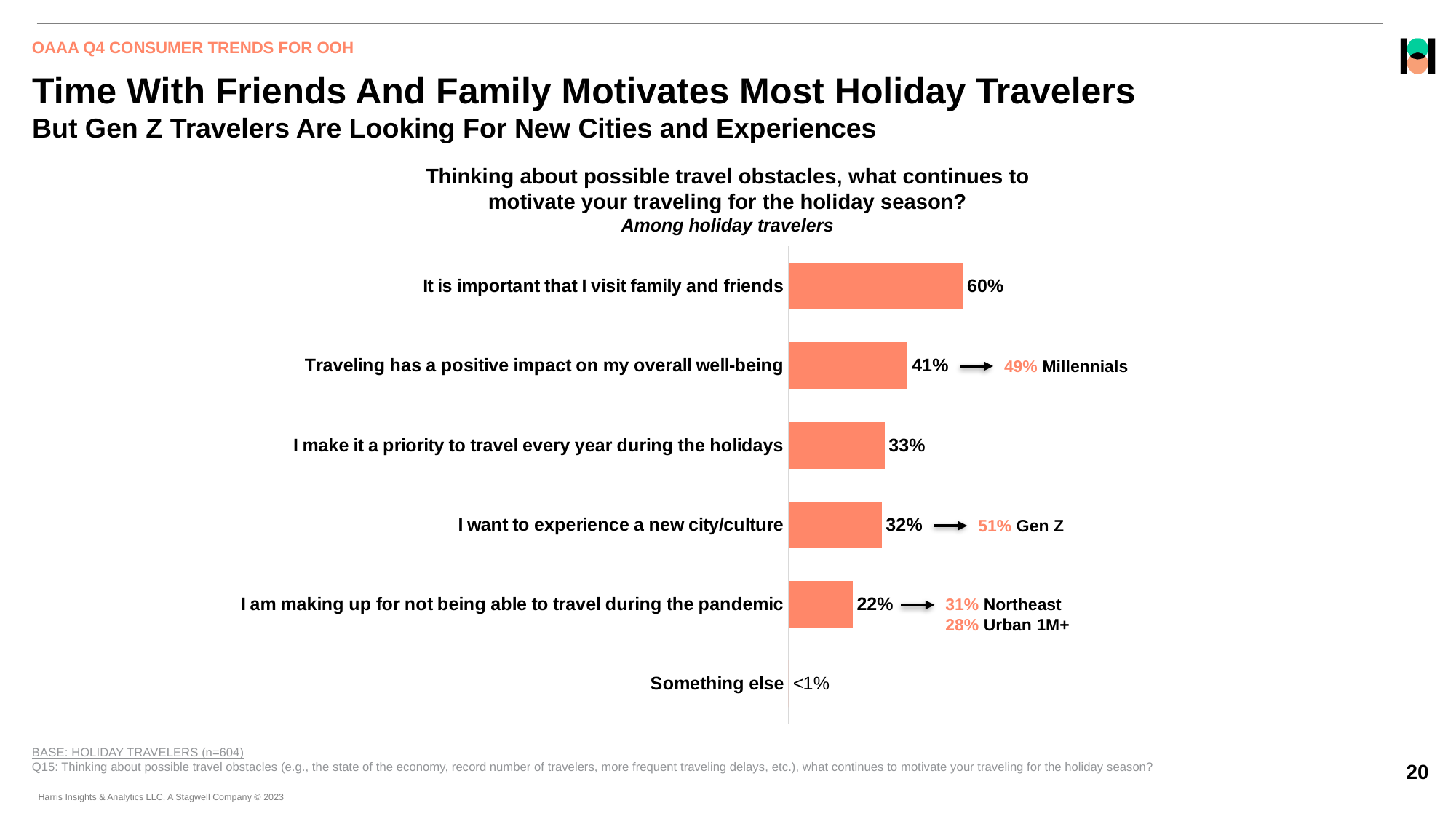
What value is shown for 'Something else'? <1% What percentage of Gen Z travelers say they want to experience a new city/culture, according to the callout? 51% What percentage of holiday travelers say they make it a priority to travel every year during the holidays? 33% What percentage of holiday travelers say traveling has a positive impact on their overall well-being? 41% Which motivation has the lowest percentage among holiday travelers? Something else Which motivation has the highest percentage among holiday travelers? It is important that I visit family and friends What percentage of holiday travelers say they are making up for not being able to travel during the pandemic? 22% What type of chart is used on this slide? Bar chart What is the difference in percentage points between 'It is important that I visit family and friends' and 'Traveling has a positive impact on my overall well-being'? 19 percentage points How many motivation categories are shown in the chart? 6 What percentage of holiday travelers say it is important that they visit family and friends? 60% Which is larger: the percentage for 'I make it a priority to travel every year during the holidays' or for 'I am making up for not being able to travel during the pandemic'? I make it a priority to travel every year during the holidays